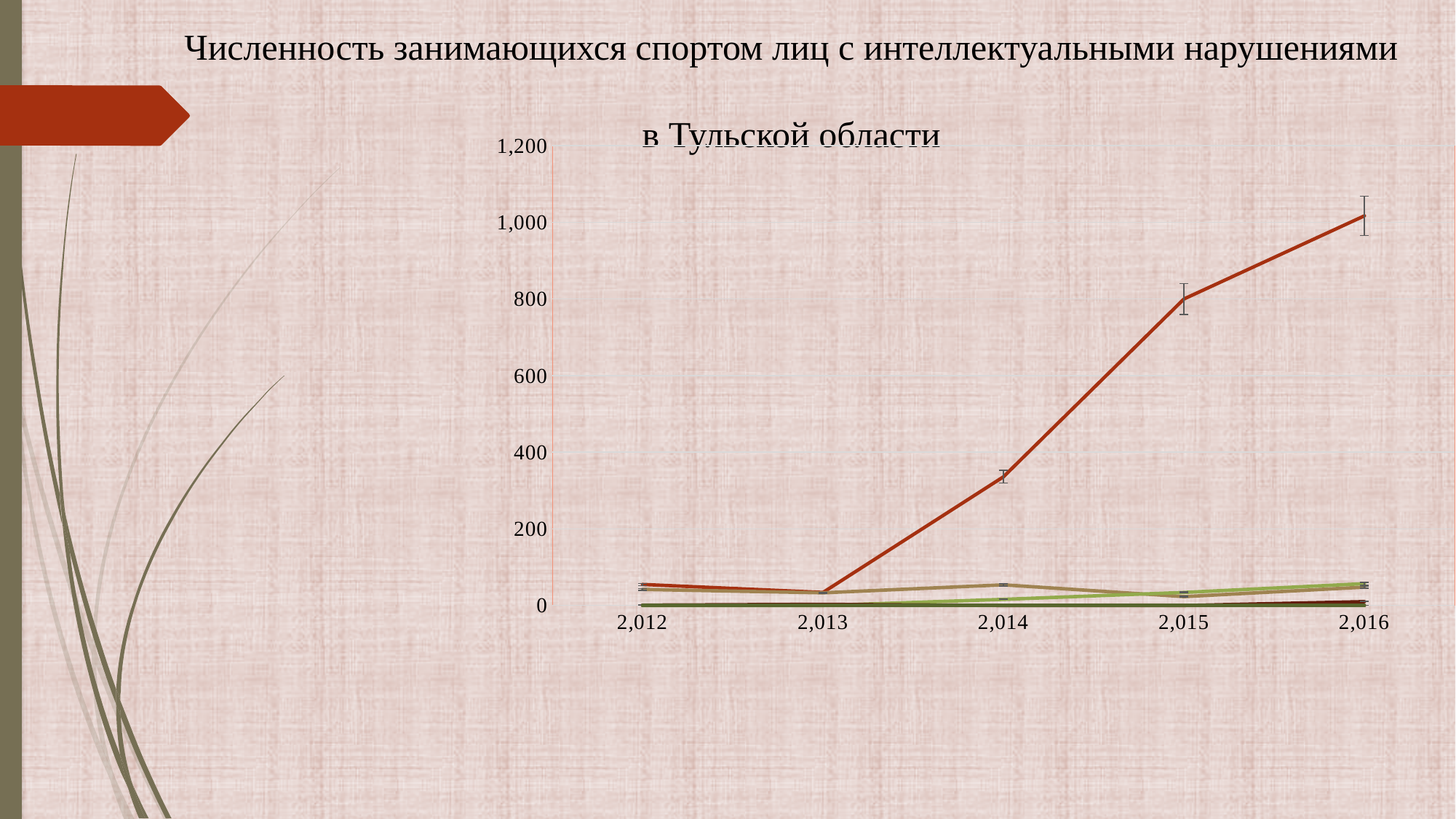
Does the red line rise or fall between 2,013 and 2,016? rise What kind of chart is shown on the slide? line chart In which year does the red line reach its highest value? 2,016 Is the value of the red line for 2,014 greater or less than 400? less Is the value of the red line for 2,015 greater or less than 600? greater Is the value of the red line for 2,013 greater or less than 200? less How many years are shown on the x axis of the chart? 5 Which year has the larger value on the red line, 2,014 or 2,015? 2,015 What is the first year shown on the x axis? 2,012 What is the title of the chart? Численность занимающихся спортом лиц с интеллектуальными нарушениями в Тульской области